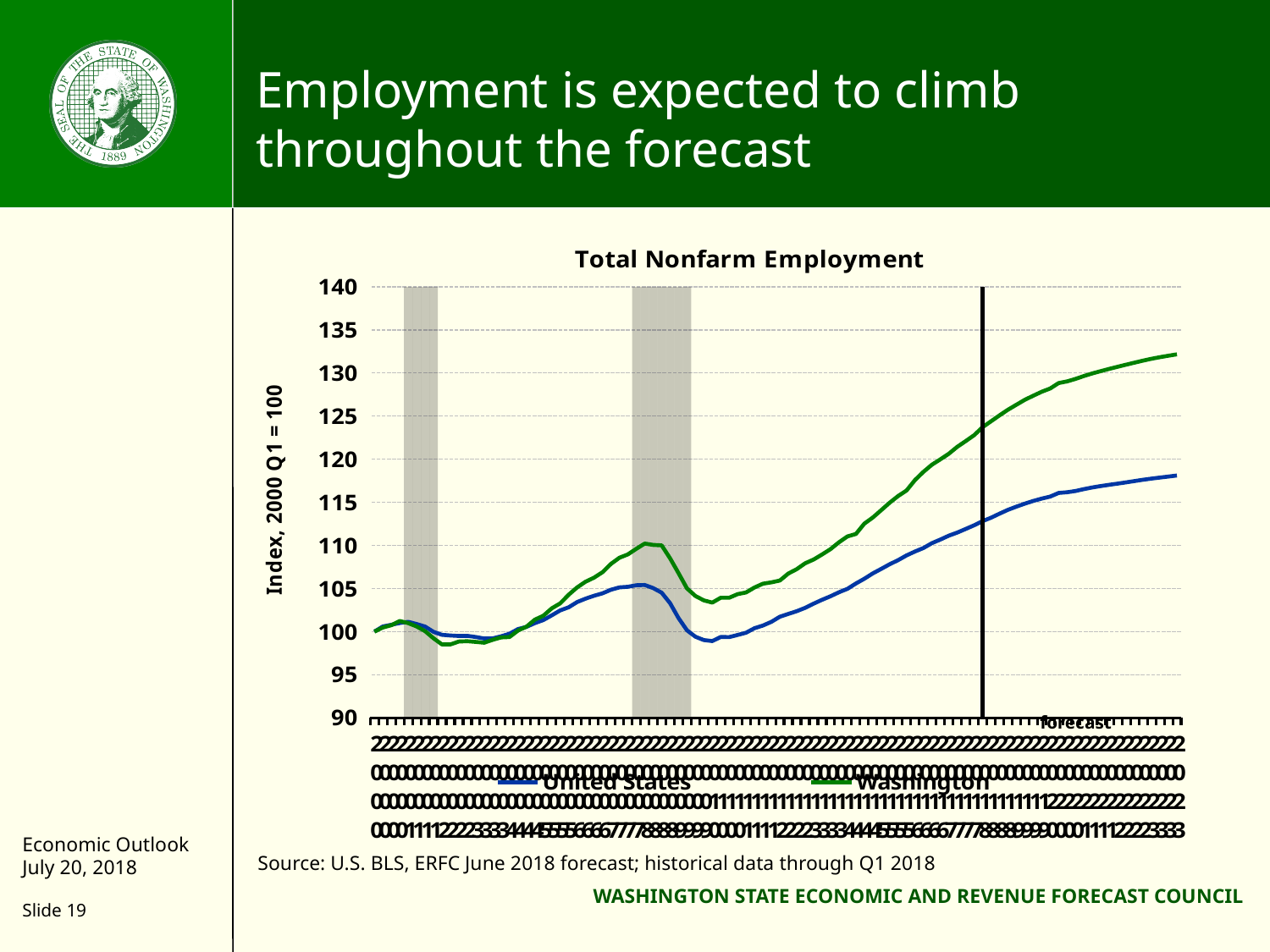
Is the United States index at the end of the forecast period greater or less than 120? less Is the Washington index at the end of the forecast period greater or less than 130? greater What is the label on the vertical axis of the chart? Index, 2000 Q1 = 100 What kind of chart is shown on the slide? Line chart What is the title of the chart? Total Nonfarm Employment Is the United States index at the end of the forecast period greater or less than 115? greater How many series does the legend of the Total Nonfarm Employment chart list? 2 What is the highest value shown on the vertical axis of the chart? 140 What is the lowest value shown on the vertical axis of the chart? 90 Over the forecast period (to the right of the vertical black line), do the two employment index lines rise or fall? rise At the right end of the forecast period, which series is higher: United States or Washington? Washington